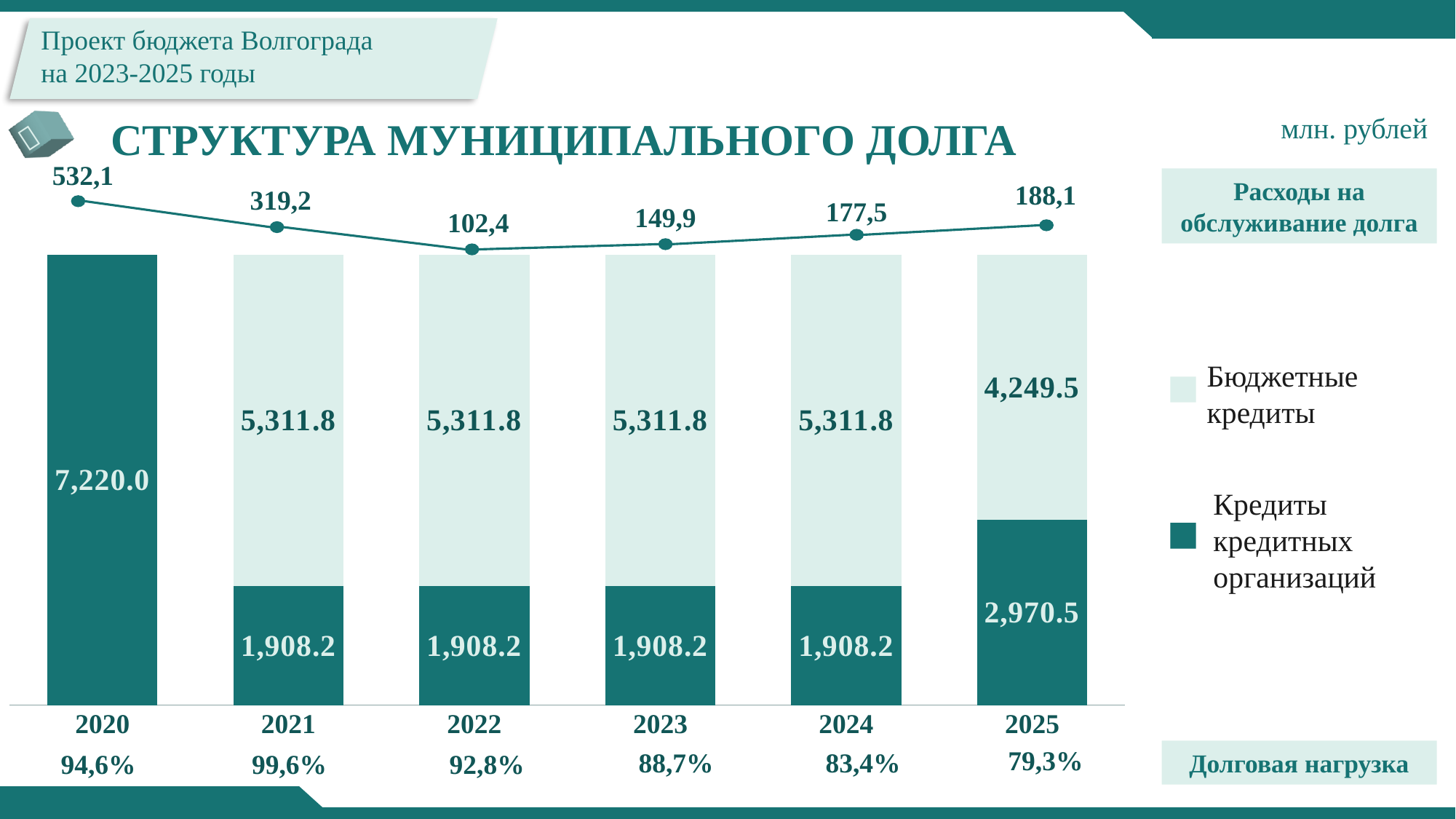
What is the value of 'Кредиты кредитных организаций' for 2021? 1,908.2 What is the total of the stacked bar for 2025? 7,220.0 What unit is stated for the values on the chart? млн. рублей In which year is 'Расходы на обслуживание долга' the lowest? 2022 How does 'Расходы на обслуживание долга' change from 2022 to 2025? It rises In which year is 'Расходы на обслуживание долга' the highest? 2020 What is the 'Долговая нагрузка' value shown for 2024? 83,4% What is the value of 'Расходы на обслуживание долга' for 2022? 102,4 Which is larger in 2025: 'Бюджетные кредиты' or 'Кредиты кредитных организаций'? Бюджетные кредиты How many years are shown on the x axis? 6 What is the difference between 'Кредиты кредитных организаций' in 2025 and in 2024? 1,062.3 What is the value of 'Бюджетные кредиты' for 2025? 4,249.5